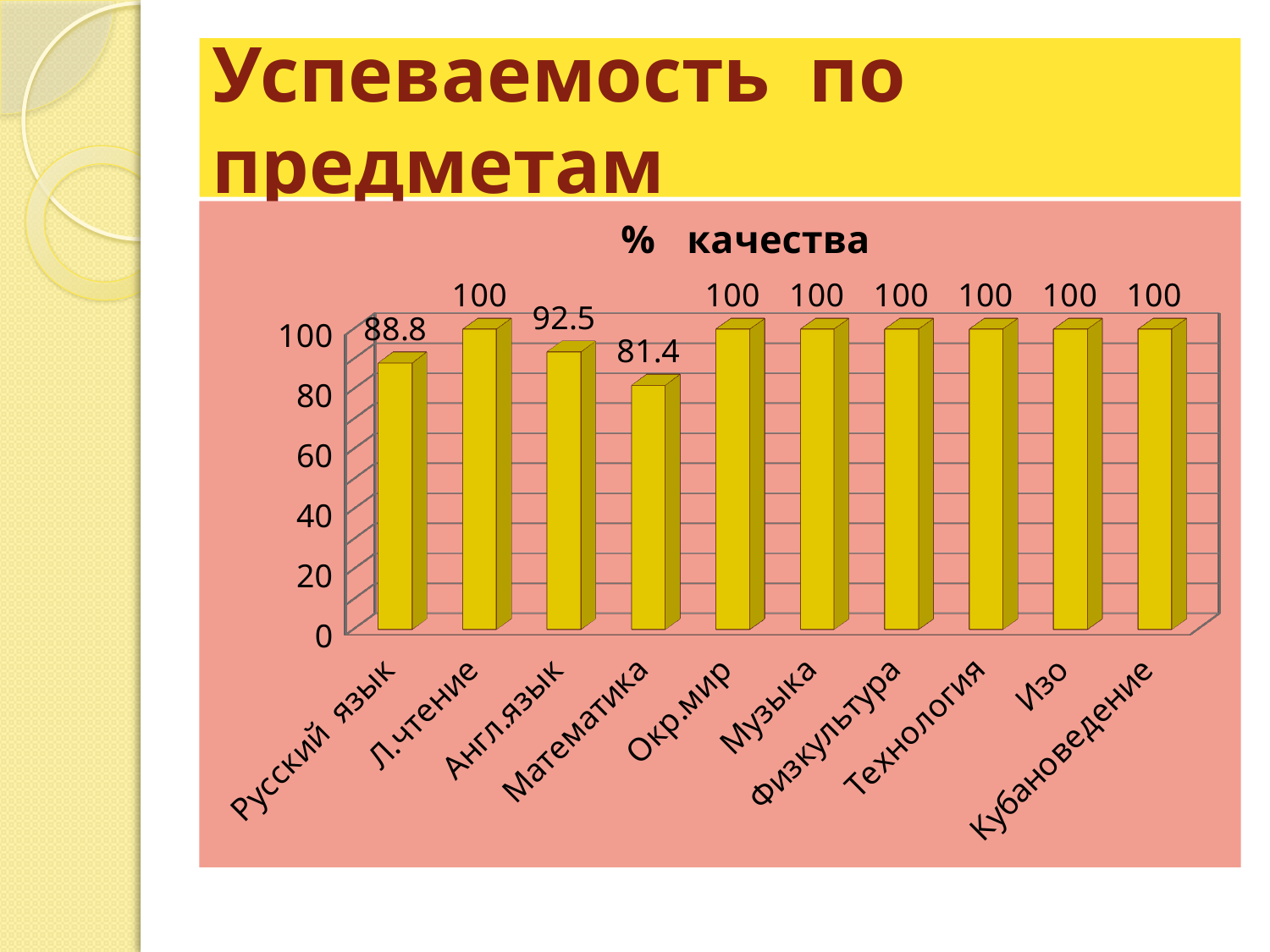
What is the difference between the values for Англ.язык and Русский язык? 3.7 Which is larger, the value for Русский язык or the value for Англ.язык? Англ.язык What is the value for Русский язык? 88.8 What is the value for Англ.язык? 92.5 Is the value for Математика greater or less than 80? greater How many subjects are shown on the chart? 10 Which subject has the lowest value? Математика What kind of chart is shown on the slide? bar chart What is the title of the chart? % качества What is the value for Музыка? 100 What is the difference between the values for Л.чтение and Математика? 18.6 What is the value for Математика? 81.4